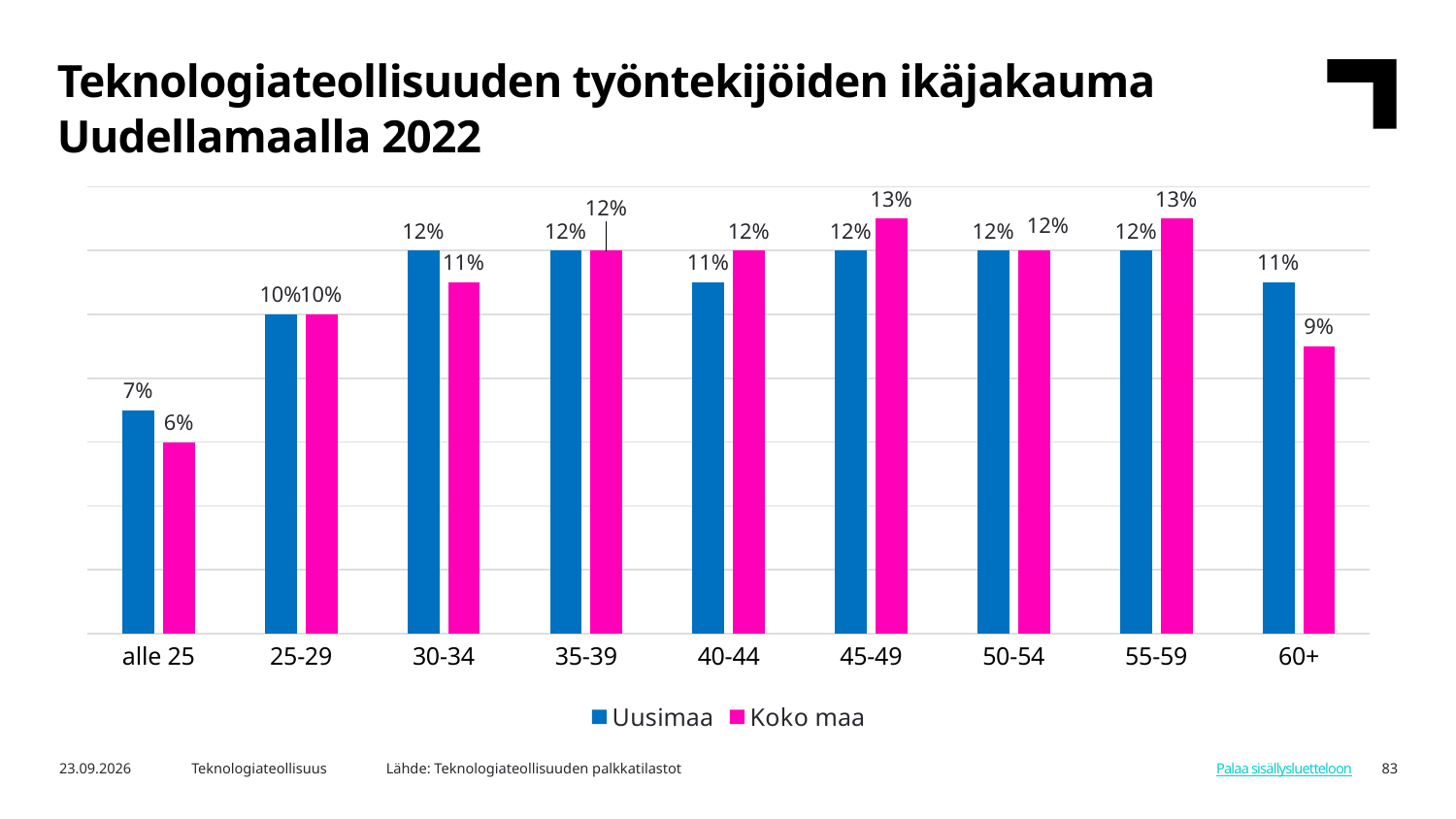
For the 30-34 age group, which is larger: Uusimaa or Koko maa? Uusimaa For the 45-49 age group, which is larger: Uusimaa or Koko maa? Koko maa What is the Koko maa value for the 60+ age group? 9% What is the Uusimaa value for the alle 25 age group? 7% How many series does the legend list? 2 What kind of chart is shown on the slide? Bar chart What is the Uusimaa value for the 40-44 age group? 11% What is the Koko maa value for the 45-49 age group? 13% How many age groups are shown on the x axis? 9 Which age group has the lowest Uusimaa value? alle 25 What is the difference between the Uusimaa and Koko maa values for the 60+ age group? 2% Which age group has the lowest Koko maa value? alle 25